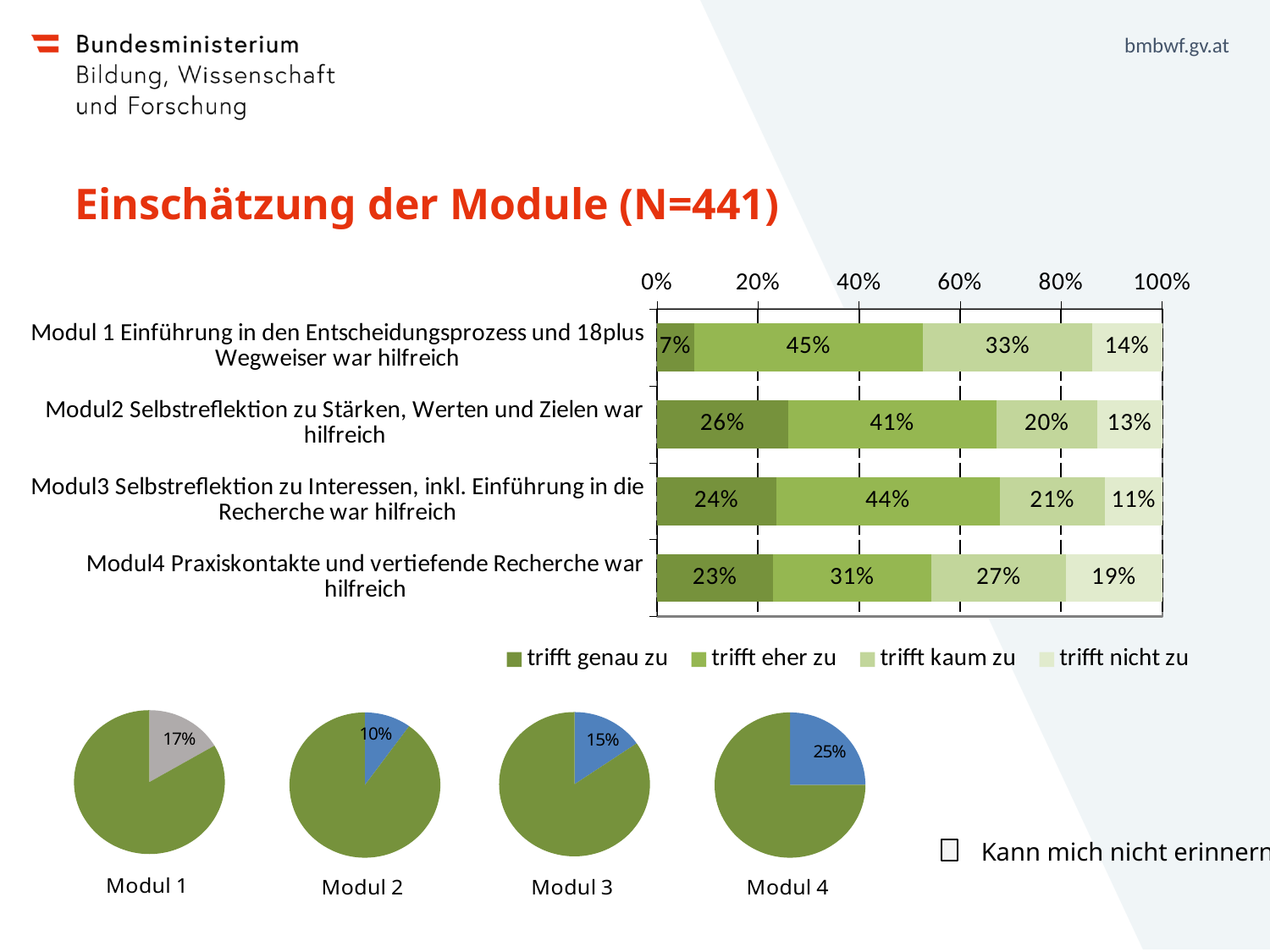
How many series does the legend of the stacked bar chart list? 4 In the stacked bar chart, what is the "trifft nicht zu" value for Modul4 Praxiskontakte und vertiefende Recherche war hilfreich? 19% What type of chart is the chart at the top of the slide showing the module ratings? Stacked bar chart In the Modul 4 pie chart at the bottom of the slide, what percentage is shown for the blue slice? 25% In the stacked bar chart, which module has the highest "trifft nicht zu" share? Modul4 Praxiskontakte und vertiefende Recherche war hilfreich In the stacked bar chart, what is the difference in percentage points between the "trifft eher zu" values for Modul 1 and Modul4? 14 percentage points In the stacked bar chart, what percentage of respondents answered "trifft eher zu" for Modul 1 Einführung in den Entscheidungsprozess und 18plus Wegweiser war hilfreich? 45% How many pie charts are shown at the bottom of the slide? 4 In the stacked bar chart, what is the "trifft genau zu" value for Modul2 Selbstreflektion zu Stärken, Werten und Zielen war hilfreich? 26% In the stacked bar chart, what is the total of the four segments for Modul2 Selbstreflektion zu Stärken, Werten und Zielen war hilfreich? 100% In the stacked bar chart, which has the larger "trifft eher zu" value: Modul2 or Modul3? Modul3 In the stacked bar chart, which module has the lowest "trifft genau zu" share? Modul 1 Einführung in den Entscheidungsprozess und 18plus Wegweiser war hilfreich